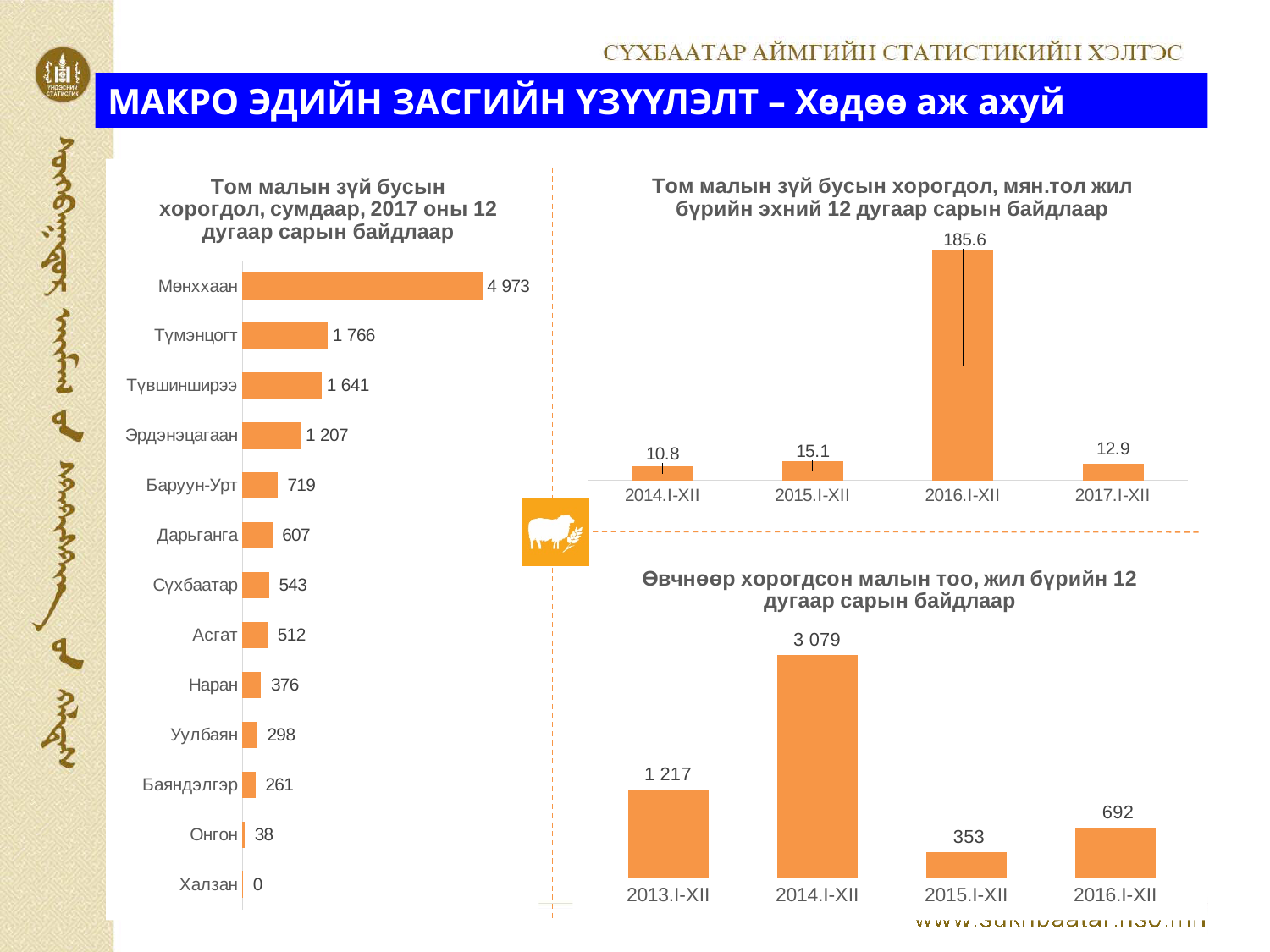
In the left chart (Том малын зүй бусын хорогдол, сумдаар), how many categories are shown? 13 In the left chart (Том малын зүй бусын хорогдол, сумдаар), what is the value for Мөнххаан? 4 973 What kind of chart is the left chart (Том малын зүй бусын хорогдол, сумдаар)? Bar chart In the top right chart (Том малын зүй бусын хорогдол, мян.тол), what is the difference between 2015.I-XII and 2017.I-XII? 2.2 In the bottom right chart (Өвчнөөр хорогдсон малын тоо), what is the value for 2014.I-XII? 3 079 In the left chart (Том малын зүй бусын хорогдол, сумдаар), which is larger, Дарьганга or Асгат? Дарьганга In the left chart (Том малын зүй бусын хорогдол, сумдаар), which category has the lowest value? Халзан In the bottom right chart (Өвчнөөр хорогдсон малын тоо), which period has the lowest value? 2015.I-XII In the top right chart (Том малын зүй бусын хорогдол, мян.тол), what is the value for 2016.I-XII? 185.6 In the bottom right chart (Өвчнөөр хорогдсон малын тоо), what is the difference between 2016.I-XII and 2015.I-XII? 339 In the left chart (Том малын зүй бусын хорогдол, сумдаар), what is the difference between Түмэнцогт and Түвшинширээ? 125 In the top right chart (Том малын зүй бусын хорогдол, мян.тол), which period has the lowest value? 2014.I-XII